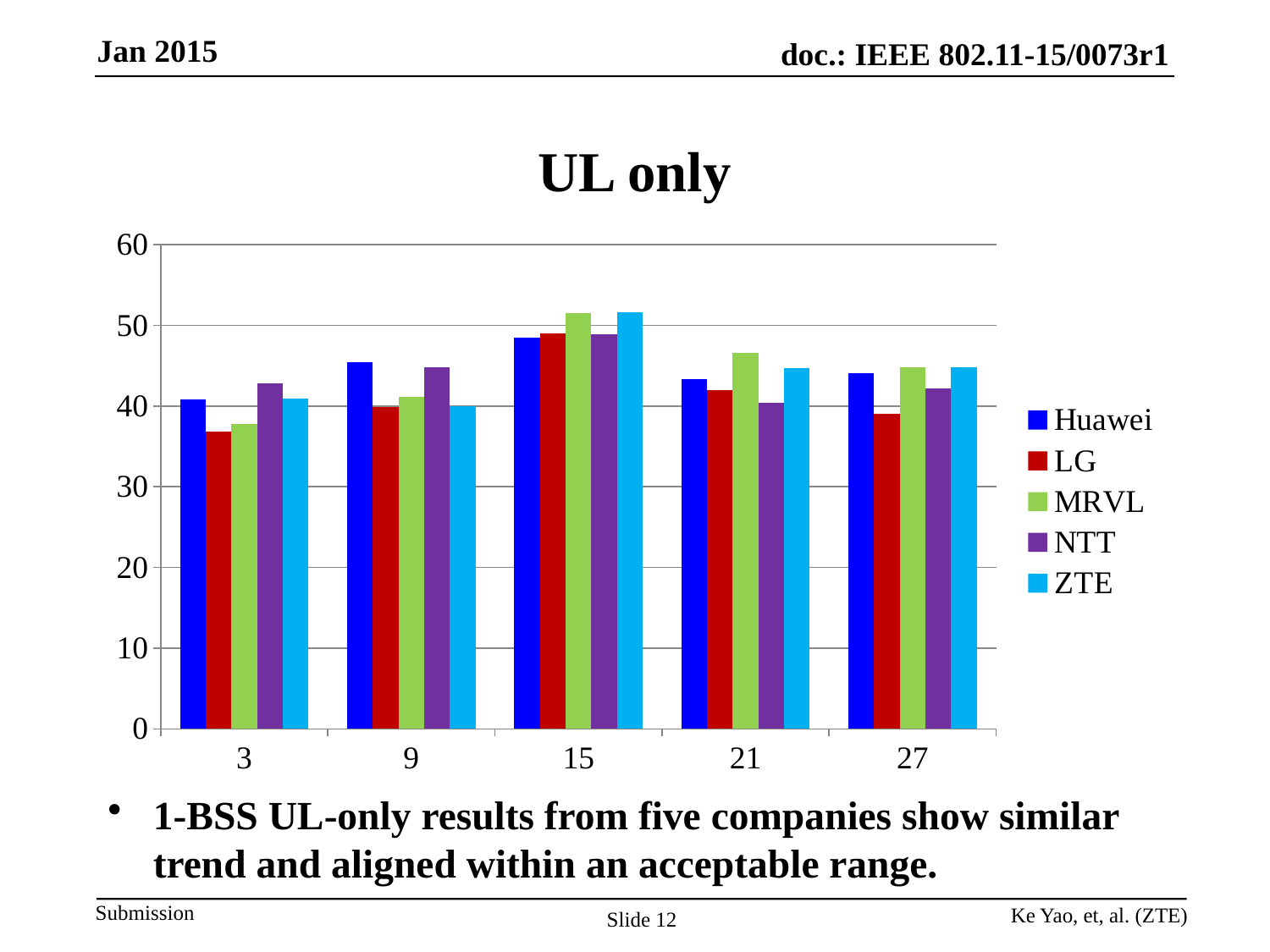
Which is larger for Huawei: the value at category 3 or at category 15? category 15 What kind of chart is shown on the slide? bar chart Is the value for Huawei at category 9 greater or less than 40? greater Is the value for LG at category 3 greater or less than 40? less Is the value for MRVL at category 15 greater or less than 50? greater Which series has the highest value at category 3? NTT Which series has the lowest value at category 27? LG How many series does the legend list? 5 Do the Huawei values rise or fall from category 3 to category 15? rise How many categories are shown on the x axis? 5 What is the title of the chart? UL only